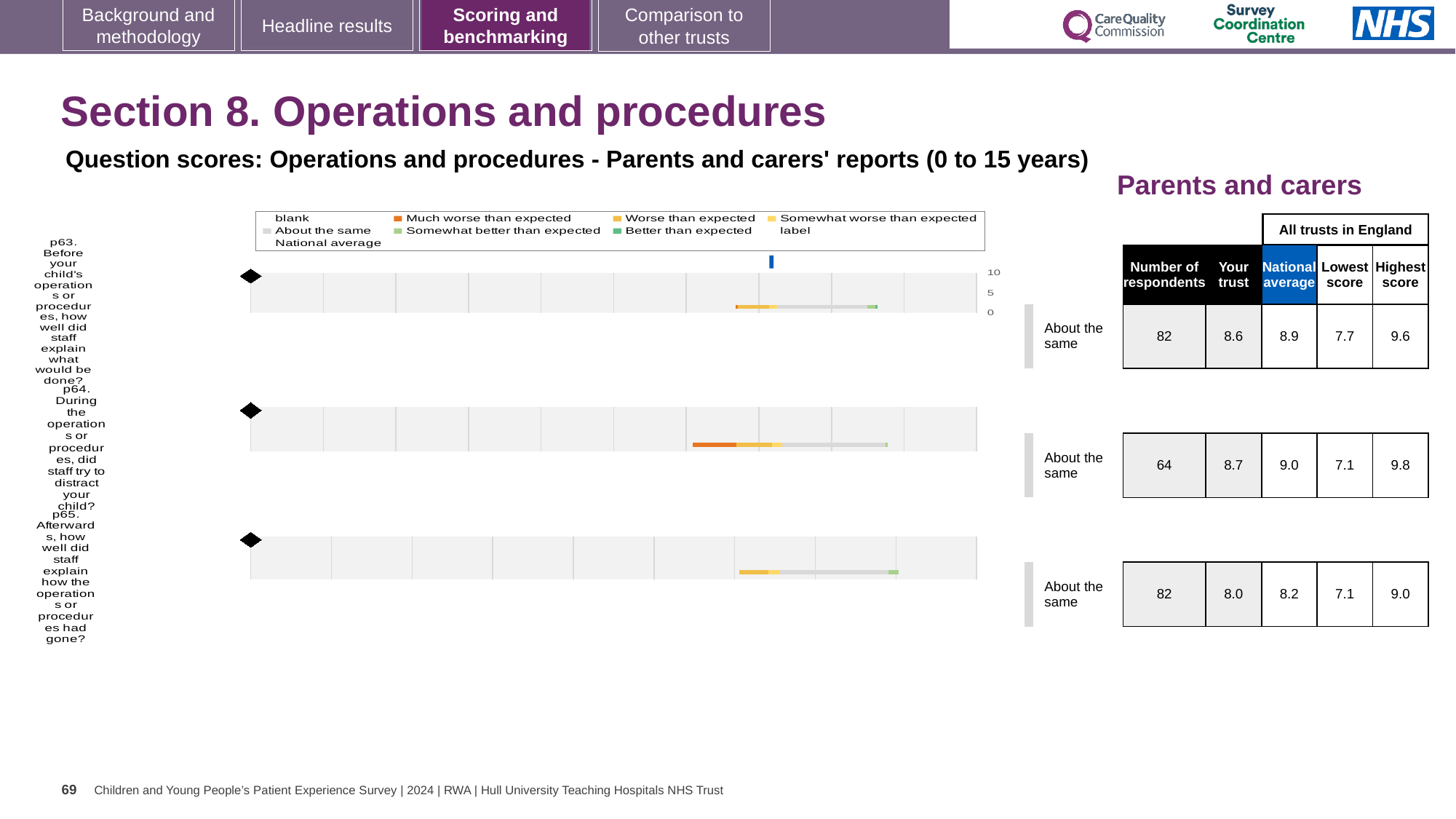
Which question has the highest 'Your trust' score? p64 What colour represents 'Much worse than expected' in the legend? Orange What is the highest score among all trusts in England for p64? 9.8 For p63, which is larger: the 'Your trust' score or the national average? National average How many respondents are shown for p65 (Afterwards, how well did staff explain how the operations or procedures had gone?)? 82 What benchmark category is shown for all three questions on the slide? About the same What is the national average score for p64 (During the operations or procedures, did staff try to distract your child?)? 9.0 What kind of chart is used for each question on the slide? bar chart How many question charts are shown on the slide? 3 Which question has the lowest 'Your trust' score? p65 For p65, what is the difference between the national average and the 'Your trust' score? 0.2 What is the 'Your trust' score for p63 (Before your child's operations or procedures, how well did staff explain what would be done?)? 8.6